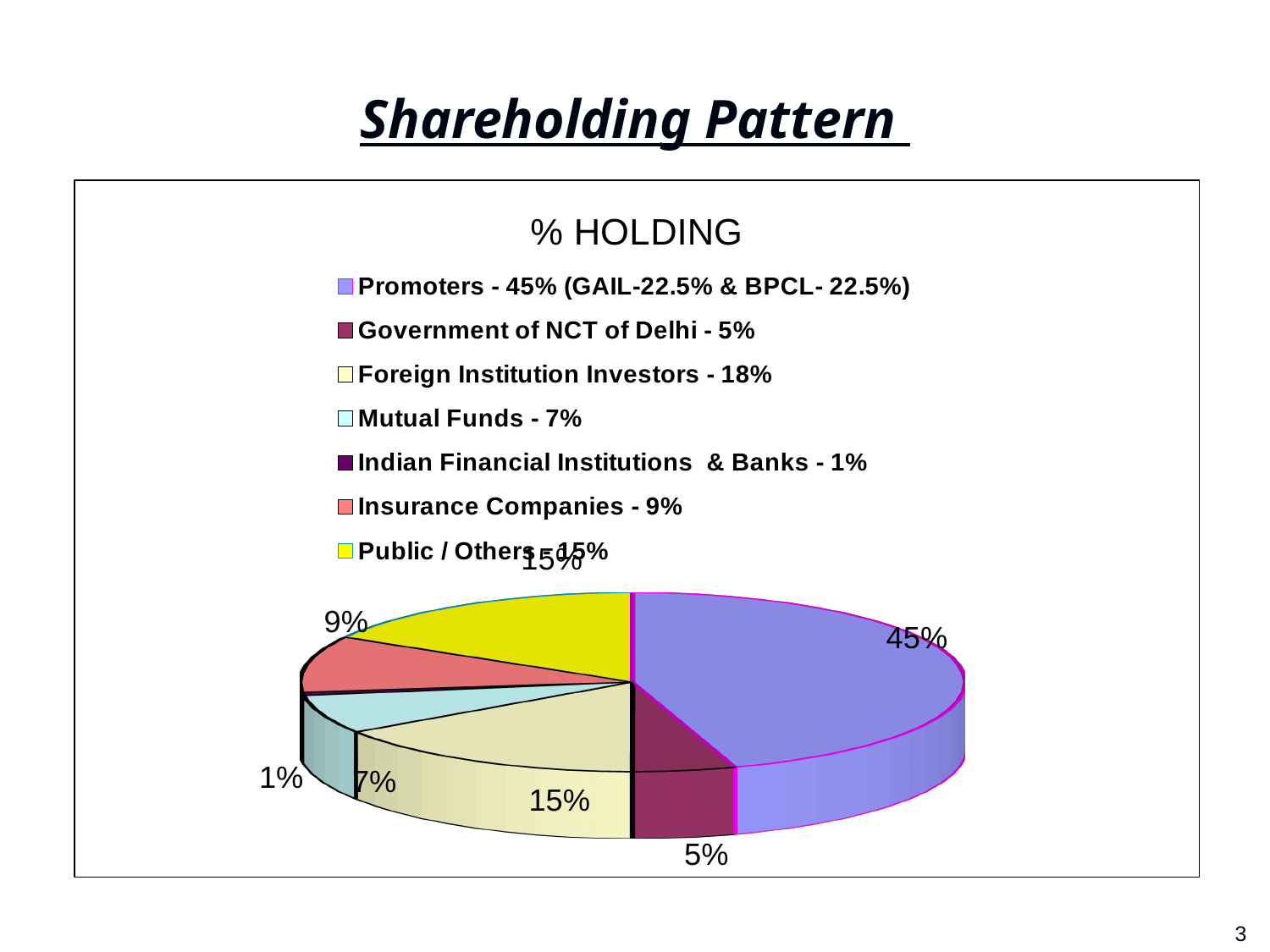
Which category holds the smallest share of the pie? Indian Financial Institutions & Banks What is the difference between the Promoters share and the Public / Others share? 30% What share of the pie is held by Public / Others? 15% Which is larger, the share for Insurance Companies or the share for Mutual Funds? Insurance Companies What share of the pie is held by Promoters? 45% What kind of chart is shown on the slide? Pie chart What share of the pie is held by Mutual Funds? 7% Which category holds the largest share of the pie? Promoters What is the title of the chart? % HOLDING How many entries does the chart's legend list? 7